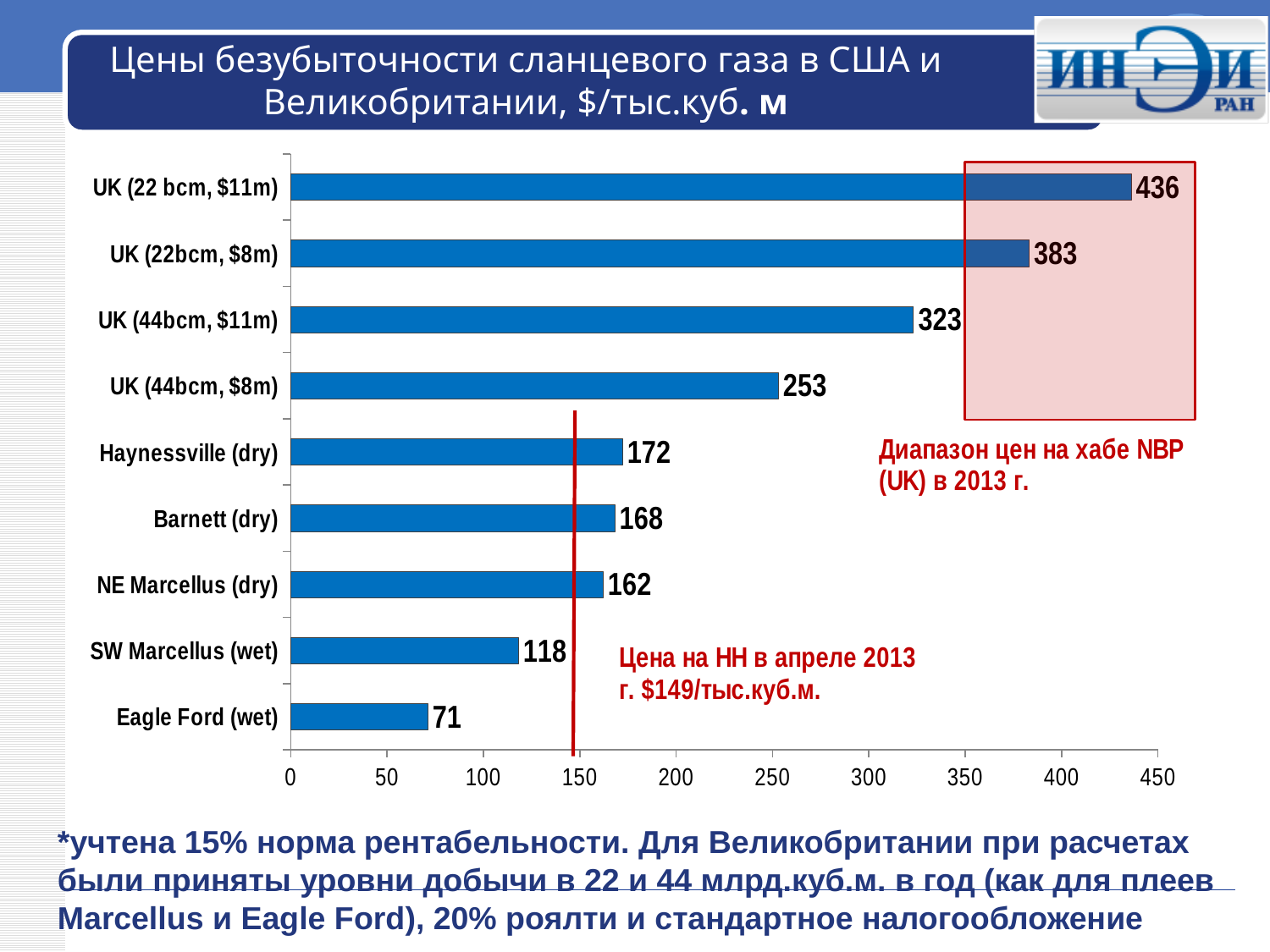
What is the value for UK (44bcm, $8m)? 253 What is the value for Haynessville (dry)? 172 What is the difference between the values for Barnett (dry) and Eagle Ford (wet)? 97 What is the value for SW Marcellus (wet)? 118 What is the difference between the values for UK (22 bcm, $11m) and UK (22bcm, $8m)? 53 What kind of chart is shown on the slide? bar chart What is the unit given in the chart title? $/тыс.куб. м Which category has the highest value? UK (22 bcm, $11m) Which category has the lowest value? Eagle Ford (wet) How many categories are shown in the chart? 9 Which is larger, the value for UK (44bcm, $11m) or the value for UK (44bcm, $8m)? UK (44bcm, $11m) Is the value for NE Marcellus (dry) greater or less than 150? greater